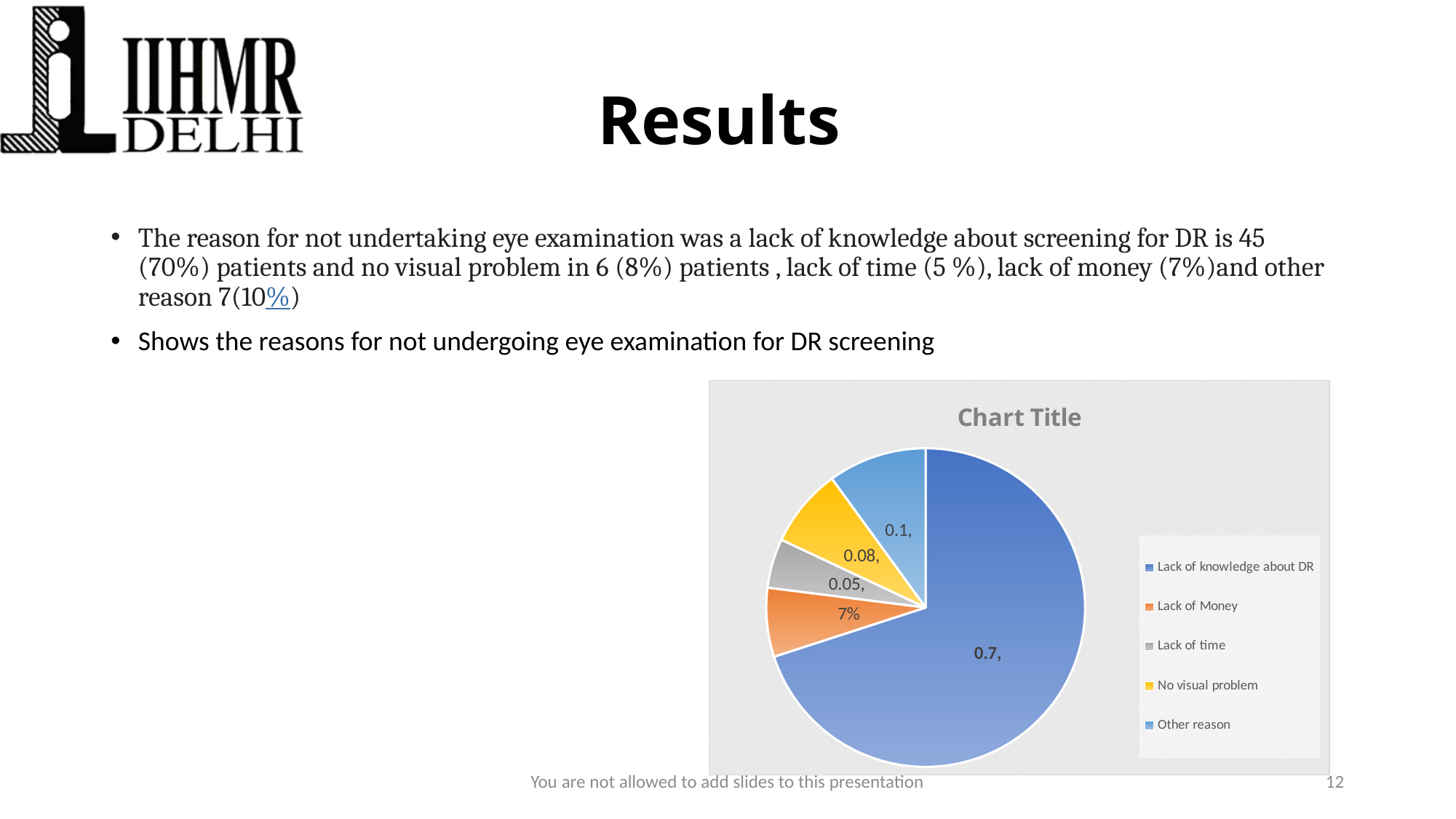
What is the value shown for the 'Lack of knowledge about DR' slice? 0.7 What kind of chart is shown on the slide? Pie chart What is the value shown for the 'Lack of time' slice? 0.05 What is the value shown for the 'Lack of Money' slice? 7% Which category has the smallest slice of the pie chart? Lack of time What is the value shown for the 'Other reason' slice? 0.1 What is the title printed above the pie chart? Chart Title What is the difference between the values for 'Other reason' and 'No visual problem'? 0.02 Which category has the largest slice of the pie chart? Lack of knowledge about DR What is the value shown for the 'No visual problem' slice? 0.08 Which slice is larger, 'No visual problem' or 'Other reason'? Other reason How many categories does the legend of the pie chart list? 5